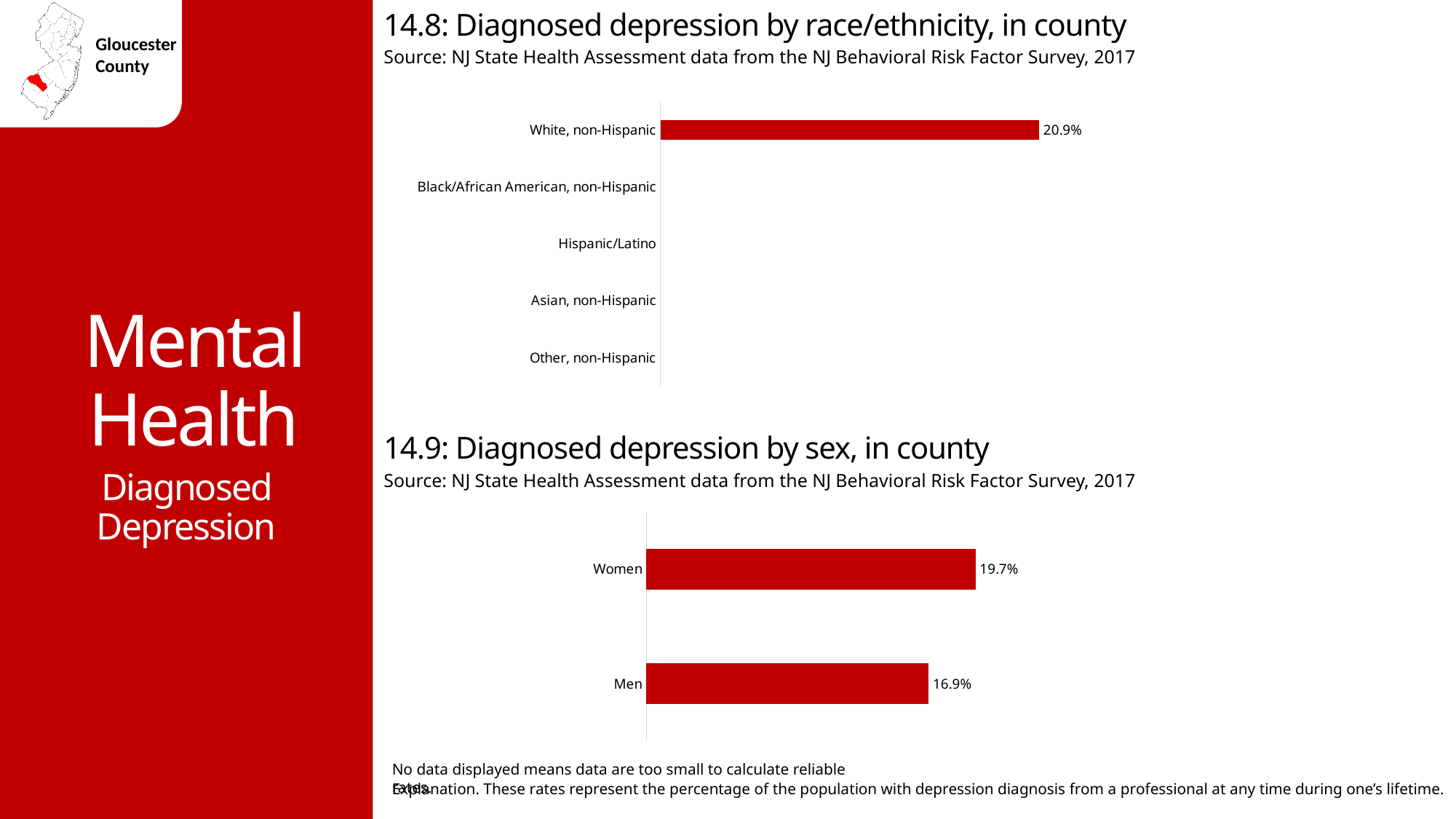
In chart 14.9 (Diagnosed depression by sex), which category has the lowest value? Men In chart 14.9 (Diagnosed depression by sex), how many categories are shown? 2 In chart 14.9 (Diagnosed depression by sex), is the value for Women or Men larger? Women In chart 14.8 (Diagnosed depression by race/ethnicity), what is the value for White, non-Hispanic? 20.9% In chart 14.9 (Diagnosed depression by sex), which category has the highest value? Women In chart 14.8 (Diagnosed depression by race/ethnicity), how many race/ethnicity categories are listed on the axis? 5 What kind of chart is chart 14.8 (Diagnosed depression by race/ethnicity)? Bar chart In chart 14.9 (Diagnosed depression by sex), what is the value for Men? 16.9% In chart 14.9 (Diagnosed depression by sex), what is the difference between the values for Women and Men? 2.8% What kind of chart is chart 14.9 (Diagnosed depression by sex)? Bar chart In chart 14.9 (Diagnosed depression by sex), what is the value for Women? 19.7% In chart 14.8 (Diagnosed depression by race/ethnicity), which category is the only one with a bar displayed? White, non-Hispanic